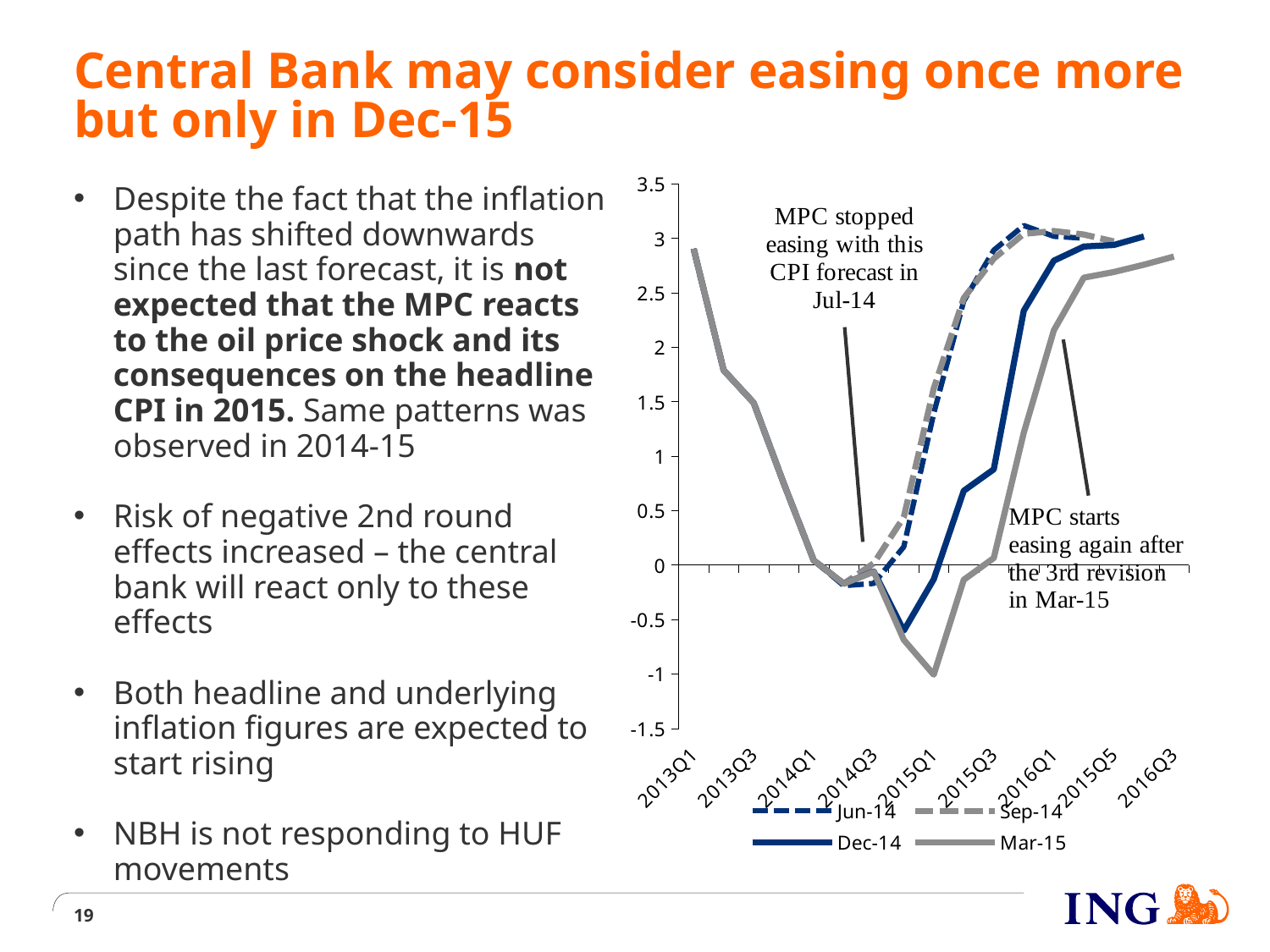
What kind of chart is shown on the slide? line chart At 2015Q1, is the Mar-15 series above or below the Dec-14 series? below What is the highest value shown on the chart's vertical axis? 3.5 Is the lowest point of the Mar-15 series greater or less than -0.5? less Which series reaches the lowest value on the chart? Mar-15 Is the value of the Mar-15 series at 2013Q1 greater or less than 2.5? greater Which series are listed in the chart's legend? Jun-14, Sep-14, Dec-14, Mar-15 Is the value of the Dec-14 series at 2016Q1 greater or less than 2.5? greater How many series does the chart's legend list? 4 Does the Mar-15 series rise or fall between 2013Q1 and 2014Q3? fall Does the Dec-14 series rise or fall between 2015Q1 and 2016Q1? rise